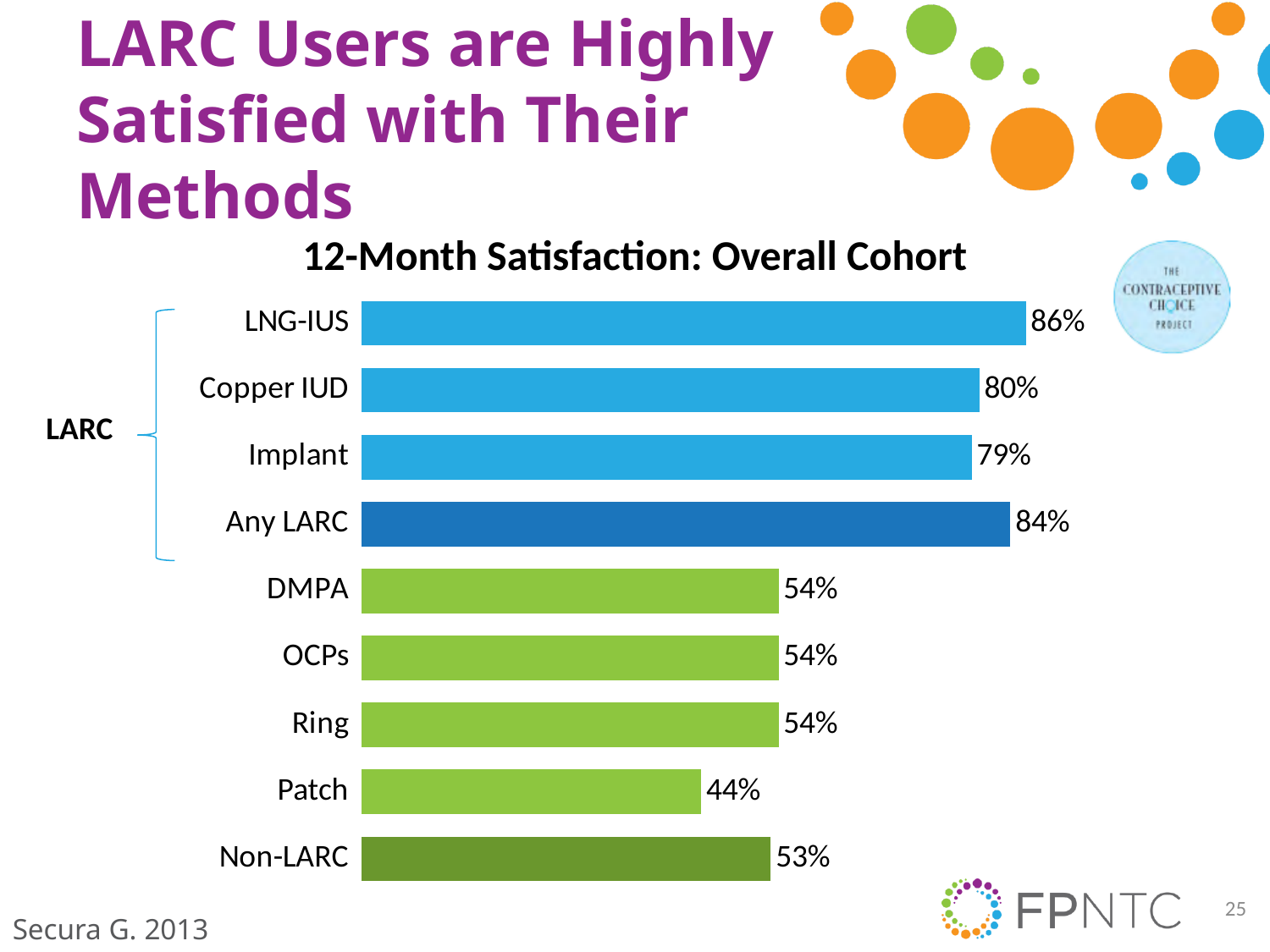
What is the 12-month satisfaction value for Patch? 44% What is the value shown for Non-LARC? 53% What is the difference between the Copper IUD value and the Implant value? 1% Which category has the highest 12-month satisfaction? LNG-IUS What is the title of the chart? 12-Month Satisfaction: Overall Cohort What kind of chart is shown on the slide? Bar chart How many categories are shown in the chart? 9 What is the 12-month satisfaction value for LNG-IUS? 86% Which is larger, the value for Implant or the value for DMPA? Implant What is the value shown for Any LARC? 84% What is the difference between the Any LARC value and the Non-LARC value? 31% Which category has the lowest 12-month satisfaction? Patch